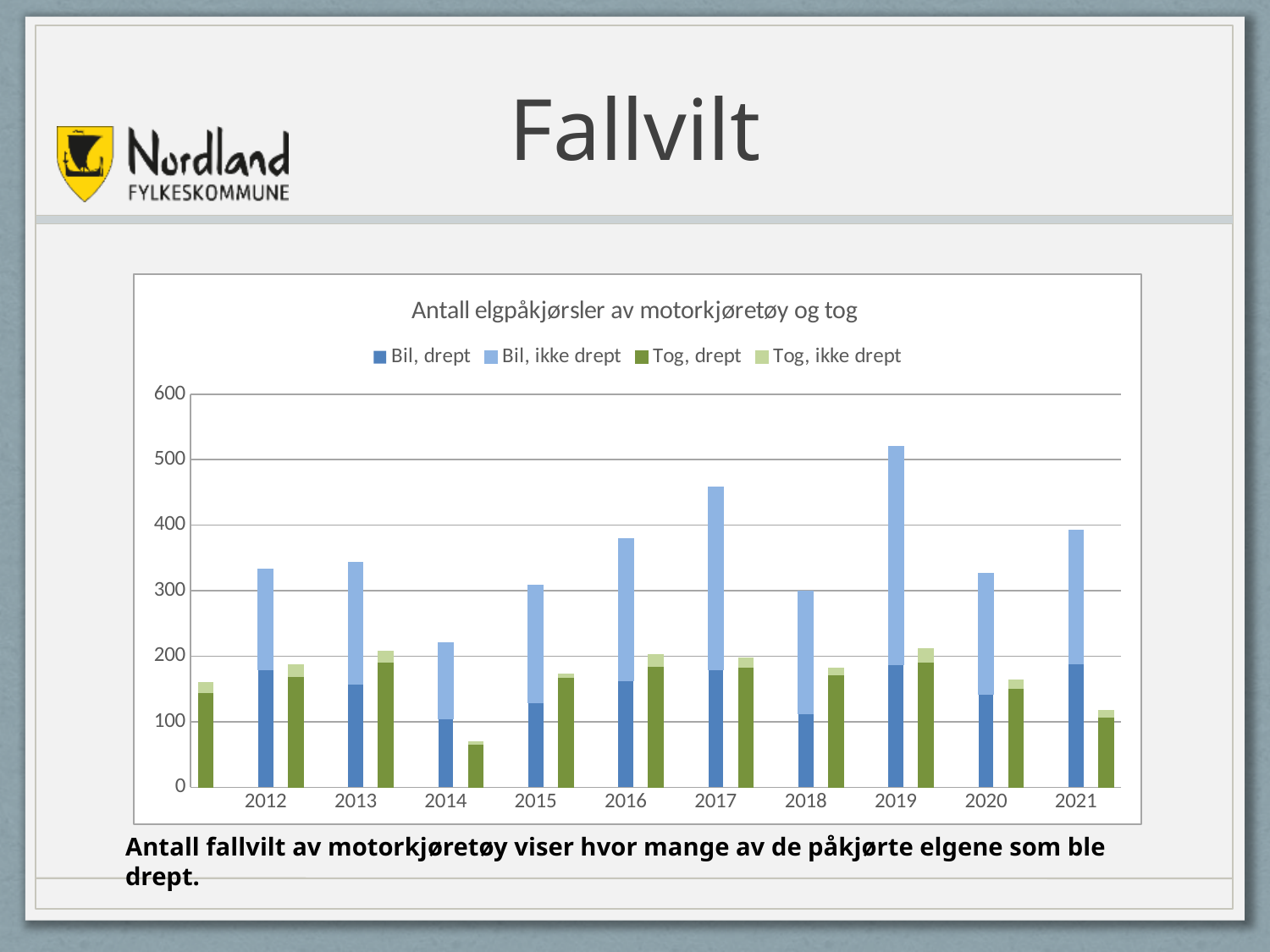
Is the total Tog (train) stack for 2014 greater or less than 100? less In which labeled year is the total Bil (car) stack the lowest? 2014 What is the title of the chart? Antall elgpåkjørsler av motorkjøretøy og tog Is the total Bil stack for 2017 greater or less than 400? greater Which legend entry is shown in dark green? Tog, drept In which year is the total Bil (car) stack the highest? 2019 How many years are labeled on the x axis? 10 What kind of chart is shown on the slide? Stacked bar chart Which year has the larger total Bil stack, 2016 or 2018? 2016 Is the total Bil stack for 2014 greater or less than 300? less How many series does the legend list? 4